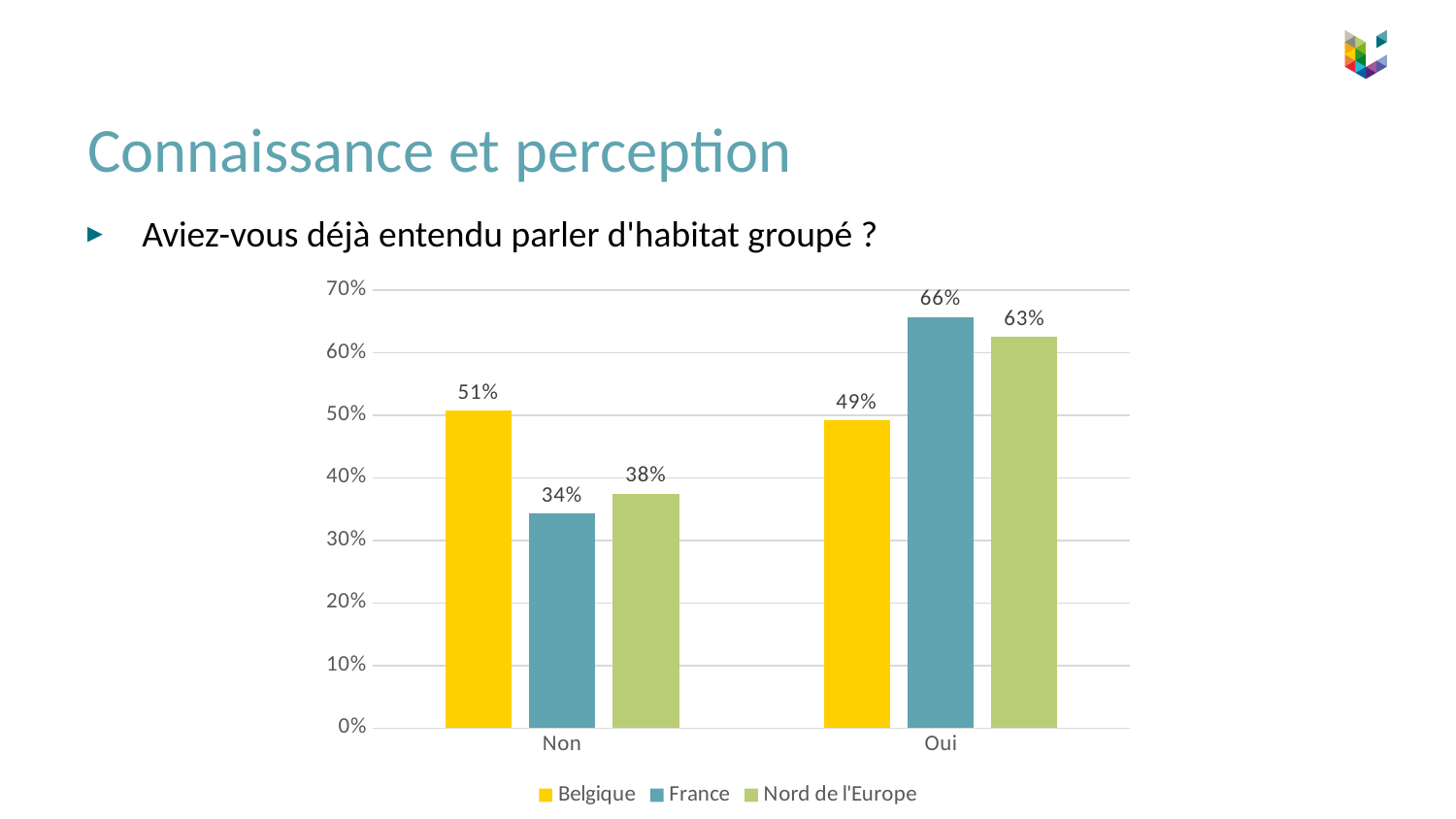
Which series has the highest value in the "Oui" category? France Is the value for Nord de l'Europe in the "Non" category greater or less than 40%? less Which series has the lowest value in the "Non" category? France How many categories are shown on the x axis? 2 Which colour represents Belgique in the chart? yellow What kind of chart is shown on the slide? bar chart What is the difference between the France values for "Oui" and "Non"? 32% What is the value for France in the "Non" category? 34% Which is larger for Belgique: the "Non" value or the "Oui" value? Non How many series does the legend list? 3 What is the value for Nord de l'Europe in the "Oui" category? 63% What is the value for Belgique in the "Oui" category? 49%